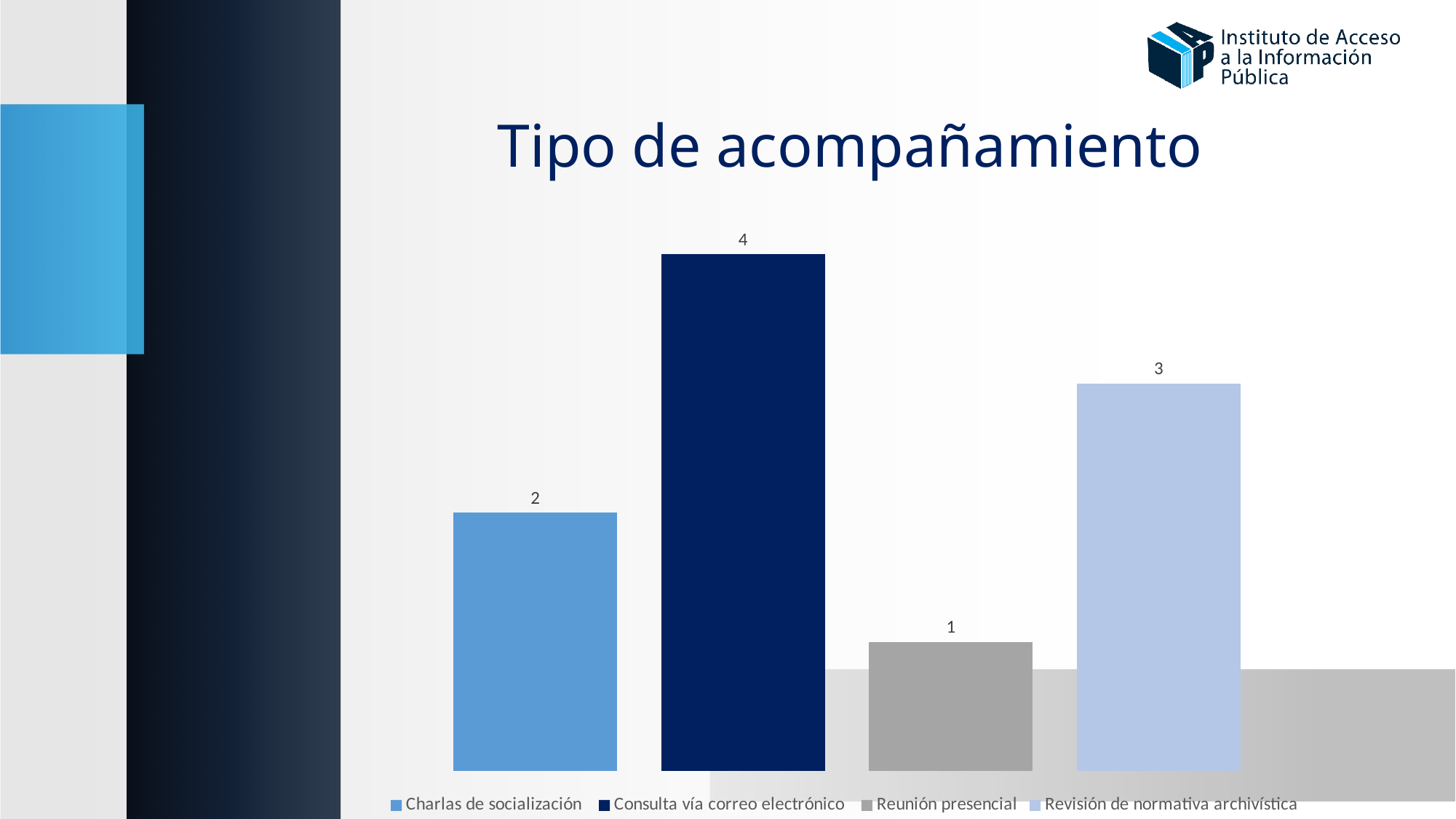
What is the value for Consulta vía correo electrónico? 4 Which category has the lowest value? Reunión presencial What is the difference between the values for Revisión de normativa archivística and Reunión presencial? 2 What is the difference between the values for Consulta vía correo electrónico and Charlas de socialización? 2 What is the value for Revisión de normativa archivística? 3 What is the value for Reunión presencial? 1 How many categories are shown in the chart? 4 Which category has the highest value? Consulta vía correo electrónico Which is larger, the value for Revisión de normativa archivística or the value for Charlas de socialización? Revisión de normativa archivística What kind of chart is shown on the slide? Bar chart What is the title of the chart? Tipo de acompañamiento What is the value for Charlas de socialización? 2